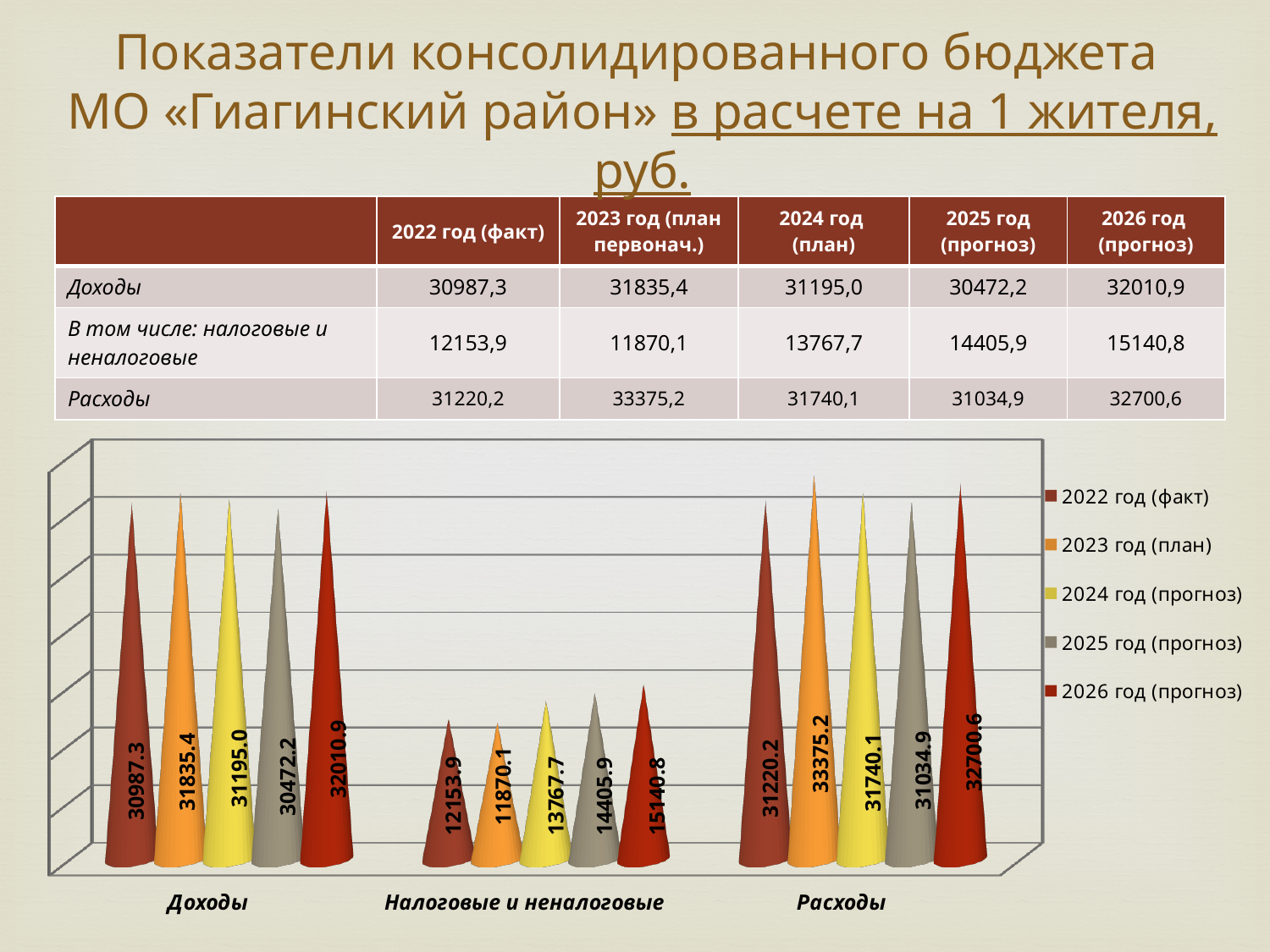
What is the difference between Расходы and Доходы in the 2023 год (план) series on the chart? 1539.8 Which category has the lowest values overall on the chart? Налоговые и неналоговые How many series does the chart legend list? 5 What kind of chart is shown on the slide? bar chart Which colour represents the 2024 год (прогноз) series in the chart legend? yellow Which is larger on the chart: Расходы or Доходы in the 2026 год (прогноз) series? Расходы What is the value for Налоговые и неналоговые in the 2025 год (прогноз) series on the chart? 14405.9 What is the value for Доходы in the 2022 год (факт) series on the chart? 30987.3 Which series has the highest value for Расходы on the chart? 2023 год (план) Which series has the lowest value for Налоговые и неналоговые on the chart? 2023 год (план) What is the value for Расходы in the 2023 год (план) series on the chart? 33375.2 How many categories are shown on the x axis of the chart? 3